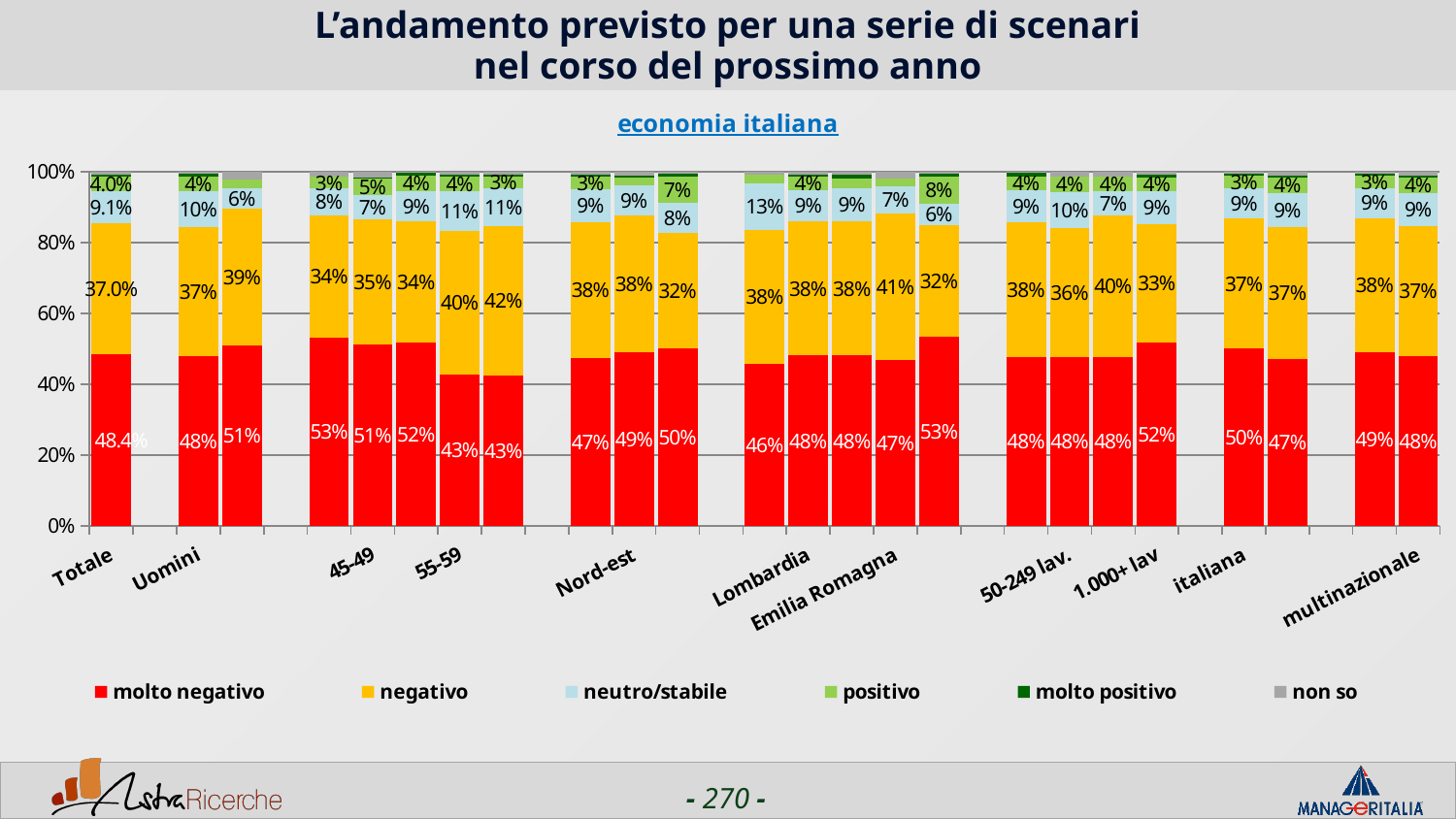
In the 'Totale' bar, what is the difference between the 'molto negativo' and 'negativo' values? 11.4 percentage points What is the value for 'neutro/stabile' in the 'Totale' bar? 9.1% What kind of chart is shown on the slide? Stacked bar chart What is the value for 'molto negativo' in the 'Lombardia' bar? 48% What is the value for 'positivo' in the 'Totale' bar? 4.0% In the 'Totale' bar, which is larger: 'molto negativo' or 'negativo'? molto negativo What is the value for 'molto negativo' in the 'Uomini' bar? 48% What is the value for 'negativo' in the 'Totale' bar? 37.0% What is the value for 'neutro/stabile' in the 'Uomini' bar? 10% What is the value for 'molto negativo' in the 'Totale' bar? 48.4% What is the value for 'molto negativo' in the '55-59' bar? 43% How many series does the legend list? 6